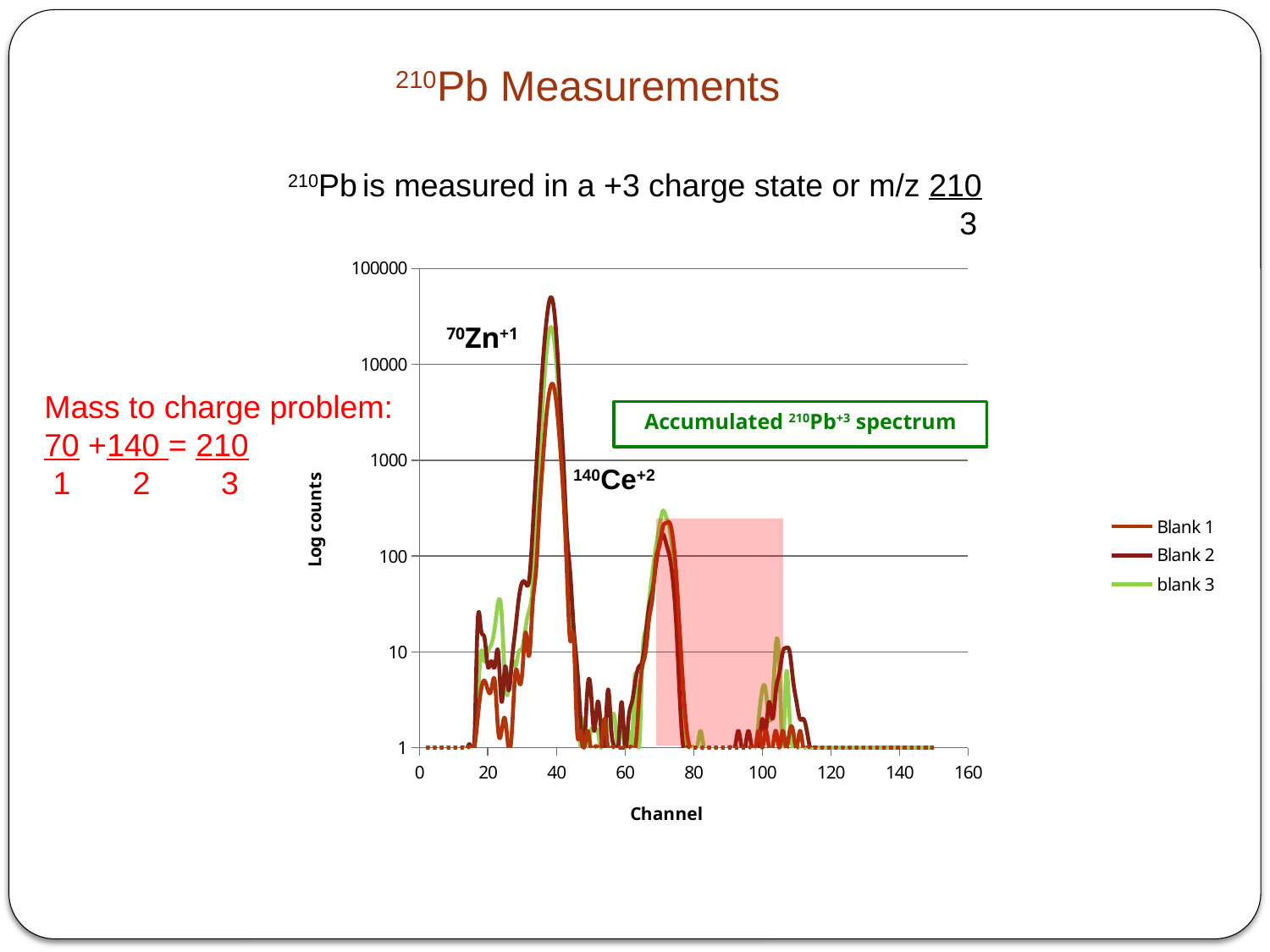
Which series has the highest peak near channel 40? Blank 2 How many series does the legend list? 3 What kind of chart is shown on the slide? line chart What are the series names listed in the legend? Blank 1, Blank 2, blank 3 What is the highest value shown on the y axis? 100000 What is the title of the x axis? Channel Which series has the lowest peak near channel 40? Blank 1 What is the highest channel value shown on the x axis? 160 What is the value of all three series at channel 140? 1 Is the peak value of Blank 2 near channel 40 greater or less than 10000? greater Is the peak value of blank 3 near channel 70 greater or less than 100? greater Is the peak value of Blank 1 near channel 40 greater or less than 10000? less